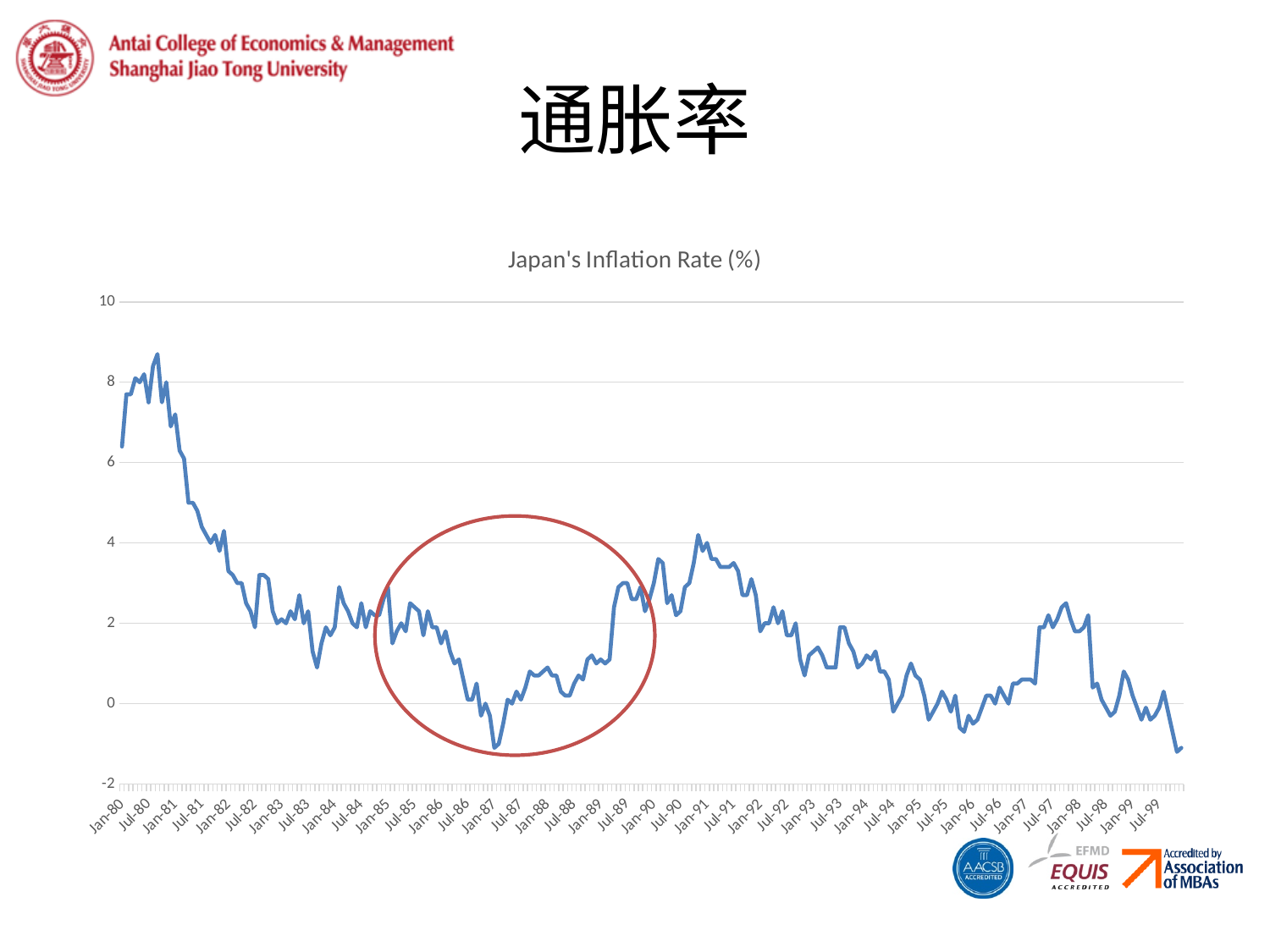
Is the inflation rate at Jan-87 greater or less than 0? less Is the inflation rate at Jan-85 greater or less than 0? greater Is the inflation rate at Jan-80 greater or less than 4? greater What is the title of the chart? Japan's Inflation Rate (%) Which is higher, the inflation rate at Jan-80 or at Jan-99? Jan-80 What kind of chart is shown on the slide? line chart Which is higher, the inflation rate at Jan-91 or at Jan-87? Jan-91 How many lines are plotted on the chart? 1 In which year does the highest inflation rate on the chart occur? 1980 Overall, does Japan's inflation rate rise or fall from Jan-80 to Jul-99? fall